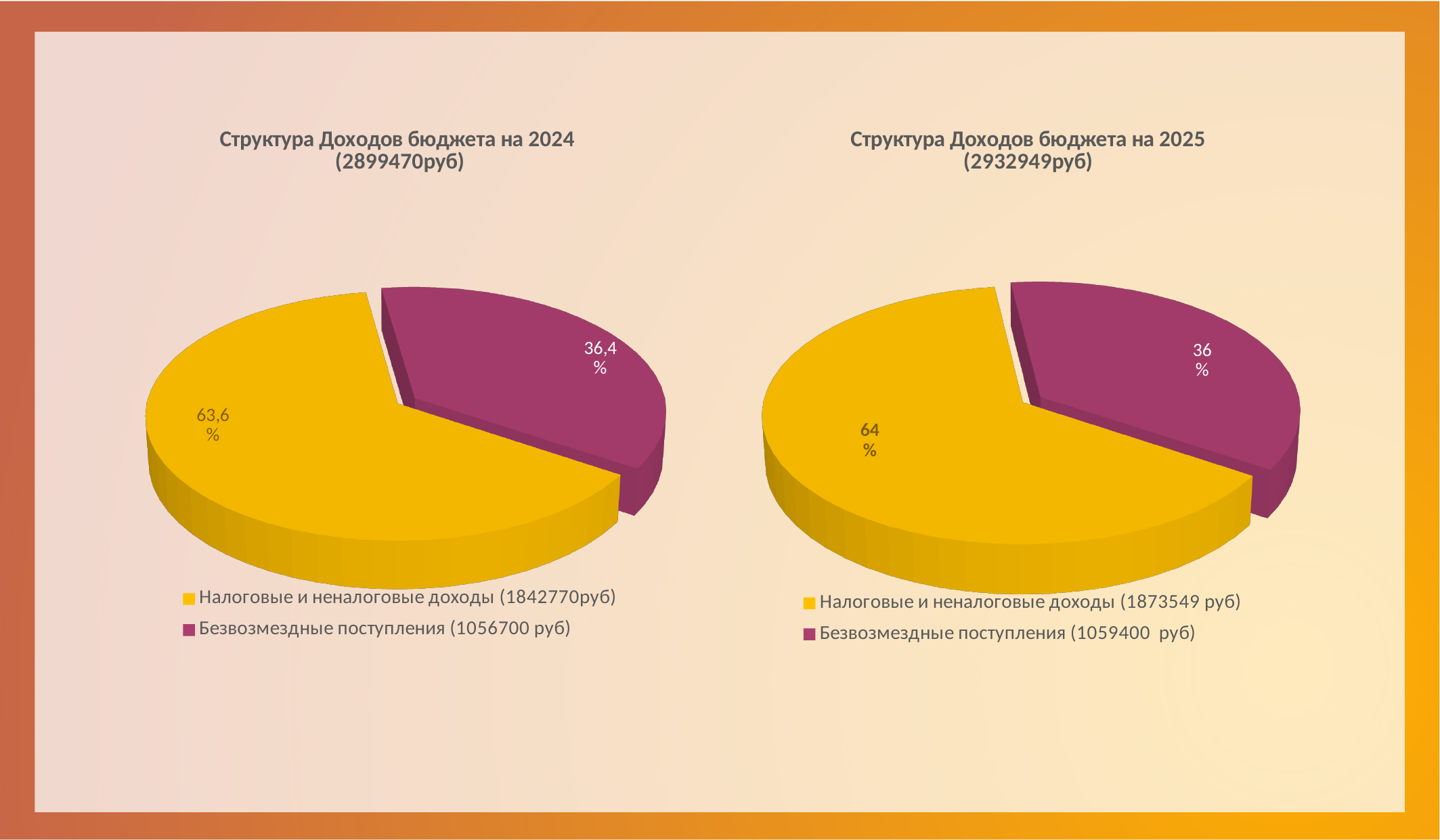
In the chart titled "Структура Доходов бюджета на 2025", what is the difference in percentage points between the two slices? 28 In the chart titled "Структура Доходов бюджета на 2024", which category has the largest slice? Налоговые и неналоговые доходы In the chart titled "Структура Доходов бюджета на 2024", what share of the pie is labelled for Безвозмездные поступления? 36,4% In the chart titled "Структура Доходов бюджета на 2025", which category has the smallest slice? Безвозмездные поступления In the chart titled "Структура Доходов бюджета на 2025", what share of the pie is labelled for Безвозмездные поступления? 36% In the chart titled "Структура Доходов бюджета на 2024", what share of the pie is labelled for Налоговые и неналоговые доходы? 63,6% What total amount is shown in the title of the right chart? 2932949руб What kind of chart is the left chart on the slide? Pie chart In the chart titled "Структура Доходов бюджета на 2024", what amount in rubles is given in the legend for Безвозмездные поступления? 1056700 руб In the chart titled "Структура Доходов бюджета на 2024", what is the difference in percentage points between the two slices? 27,2 How many slices does the chart titled "Структура Доходов бюджета на 2025" have? 2